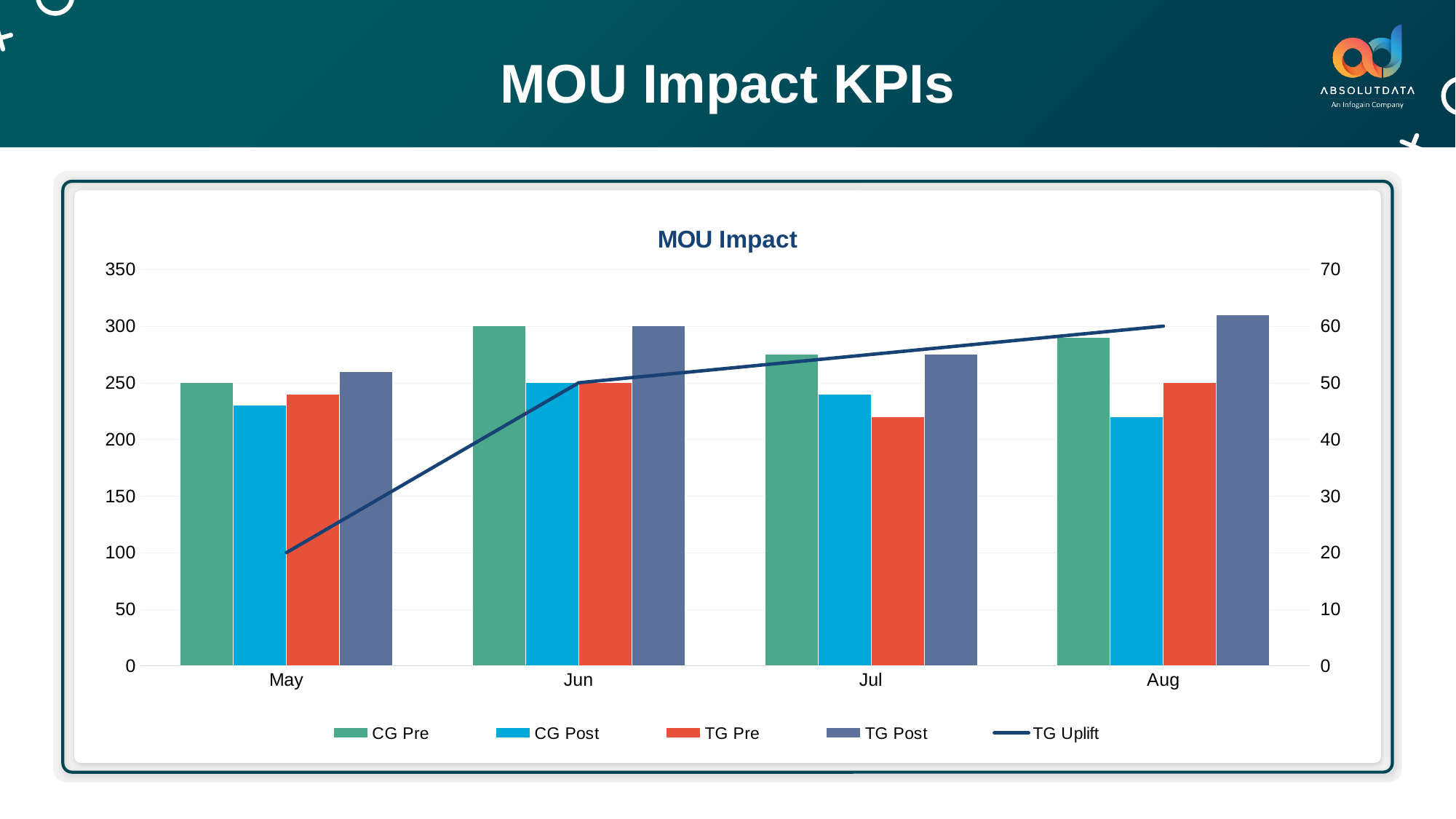
What is the TG Uplift value in May on the right axis? 20 In which month is TG Pre lowest? Jul Which is larger in Jul, CG Pre or CG Post? CG Pre What is the value of TG Post in Jun? 300 How many months are shown on the x axis? 4 What is the TG Uplift value in Aug on the right axis? 60 What kind of chart is shown on the slide? A combined bar and line chart How many series does the legend list? 5 Is the value for TG Post in Aug greater or less than 300? greater In which month is TG Post highest? Aug What is the value of CG Pre in May? 250 Does the TG Uplift line rise or fall from May to Aug? Rises